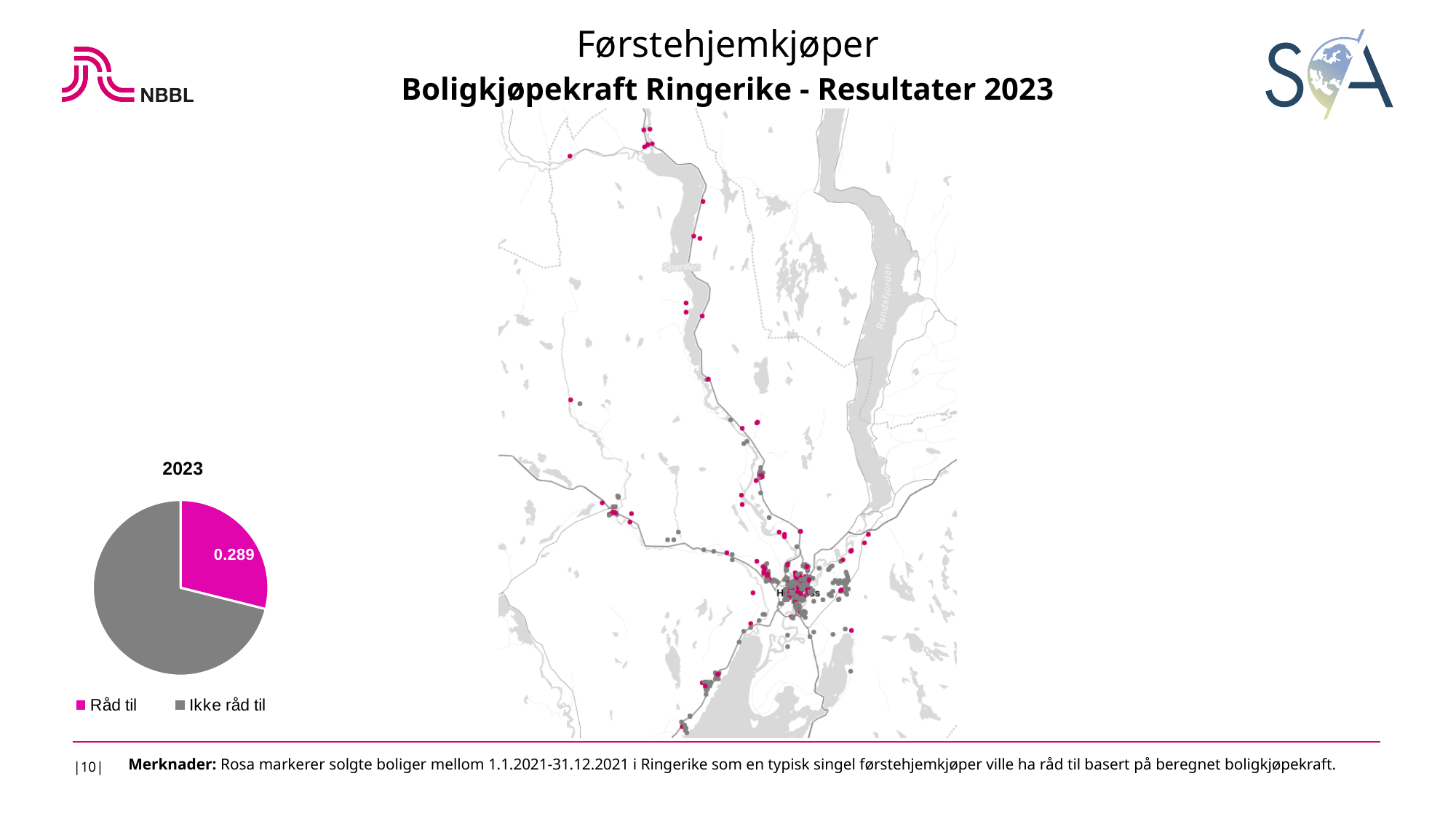
Which slice of the pie chart is the largest? Ikke råd til How many entries does the pie chart's legend list? 2 What is the title shown above the pie chart? 2023 Which slice of the pie chart is the smallest? Råd til In the pie chart, which is larger: 'Råd til' or 'Ikke råd til'? Ikke råd til What kind of chart is shown on the left of the slide? pie chart How many slices does the pie chart have? 2 What colour is the 'Råd til' slice in the pie chart? pink What share of the pie chart does the 'Råd til' slice represent, as labelled? 0.289 In the pie chart, what value is printed on the 'Råd til' slice? 0.289